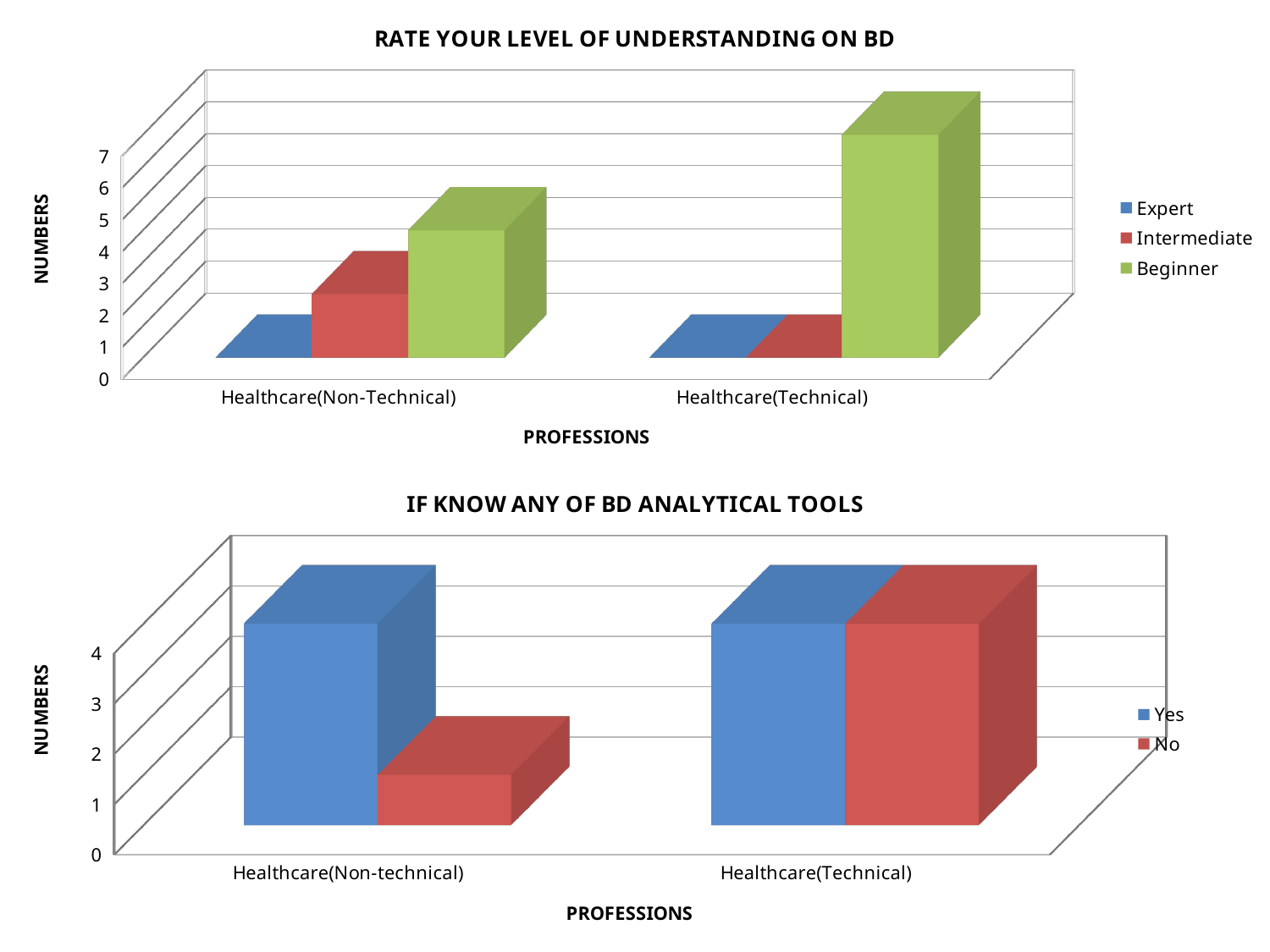
In the top chart 'RATE YOUR LEVEL OF UNDERSTANDING ON BD', what is the label of the y axis? NUMBERS In the top chart 'RATE YOUR LEVEL OF UNDERSTANDING ON BD', how many profession categories are shown on the x axis? 2 In the top chart 'RATE YOUR LEVEL OF UNDERSTANDING ON BD', which category has the larger Beginner value, Healthcare(Non-Technical) or Healthcare(Technical)? Healthcare(Technical) In the top chart 'RATE YOUR LEVEL OF UNDERSTANDING ON BD', how many series does the legend list? 3 In the bottom chart 'IF KNOW ANY OF BD ANALYTICAL TOOLS', is the Yes value for Healthcare(Non-technical) greater or less than 2? greater In the top chart 'RATE YOUR LEVEL OF UNDERSTANDING ON BD', which series has the tallest bar for Healthcare(Technical)? Beginner In the top chart 'RATE YOUR LEVEL OF UNDERSTANDING ON BD', is the Beginner value for Healthcare(Technical) greater or less than 4? greater In the bottom chart 'IF KNOW ANY OF BD ANALYTICAL TOOLS', how many series does the legend list? 2 In the top chart 'RATE YOUR LEVEL OF UNDERSTANDING ON BD', is the Beginner value for Healthcare(Non-Technical) greater or less than 2? greater What kind of chart is the top chart titled 'RATE YOUR LEVEL OF UNDERSTANDING ON BD'? bar chart In the bottom chart 'IF KNOW ANY OF BD ANALYTICAL TOOLS', which is larger for Healthcare(Non-technical), Yes or No? Yes